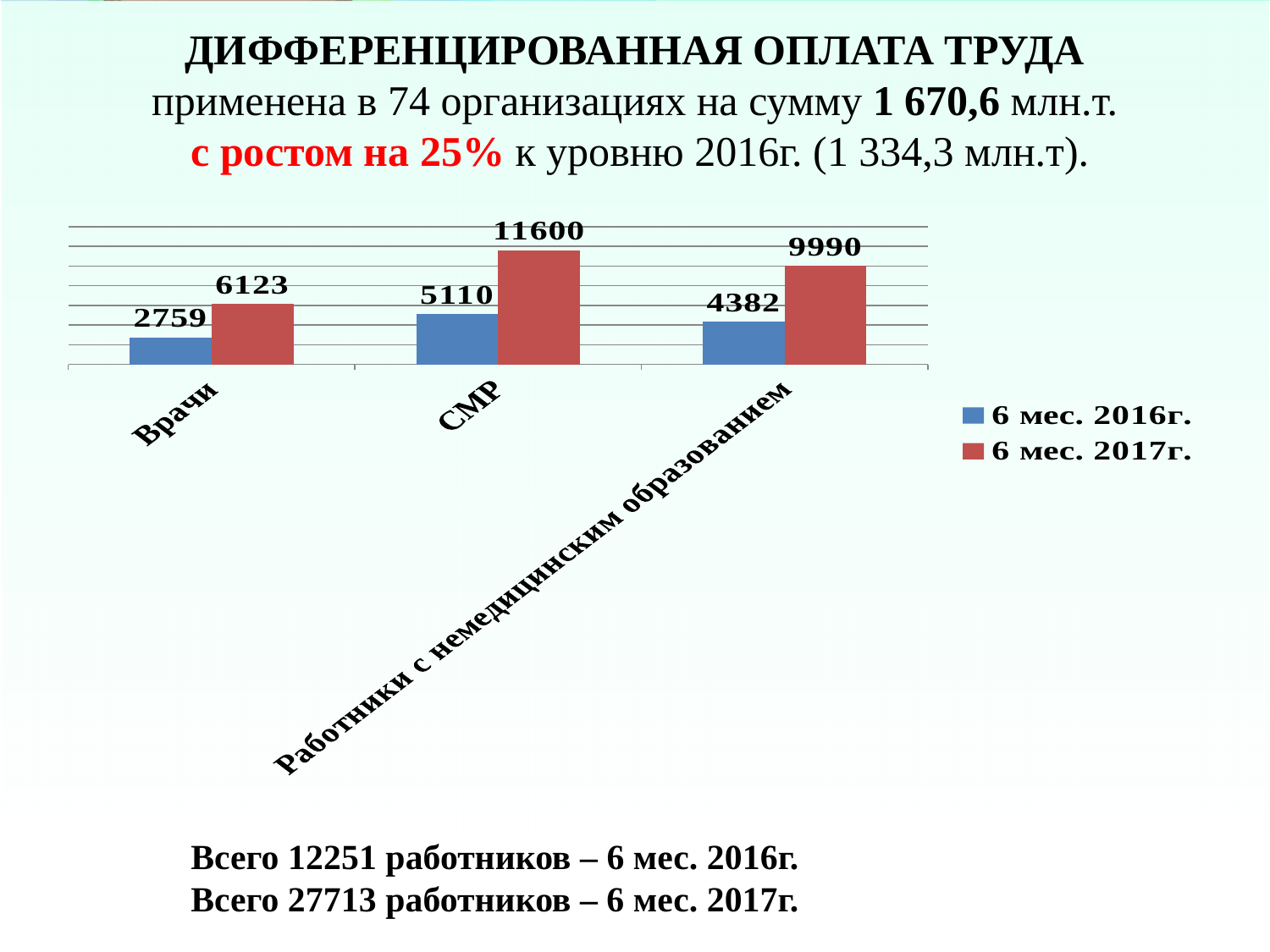
Which colour represents the 6 мес. 2017г. series? Red Which category has the highest value in the 6 мес. 2017г. series? СМР What is the difference between the 6 мес. 2017г. and 6 мес. 2016г. values for Врачи? 3364 What is the value for Работники с немедицинским образованием in the 6 мес. 2016г. series? 4382 How many categories are shown on the x axis? 3 How many series does the legend list? 2 Which is larger: the 6 мес. 2017г. value for Врачи or the 6 мес. 2016г. value for СМР? 6 мес. 2017г. value for Врачи What kind of chart is shown on the slide? Bar chart What is the value for Врачи in the 6 мес. 2016г. series? 2759 What is the value for СМР in the 6 мес. 2017г. series? 11600 Which category has the lowest value in the 6 мес. 2016г. series? Врачи What is the difference between the 6 мес. 2017г. and 6 мес. 2016г. values for СМР? 6490